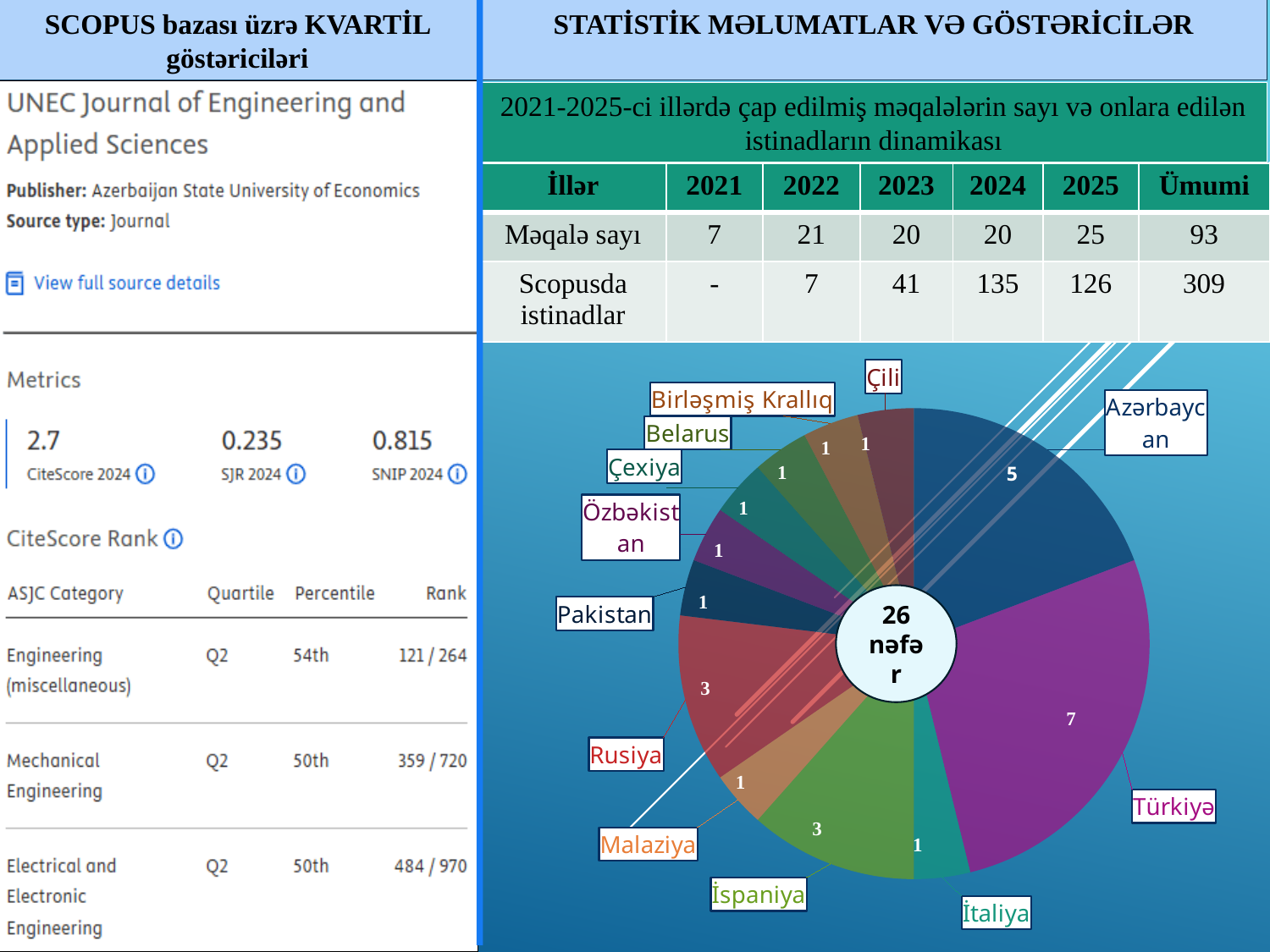
What value is shown for Rusiya in the pie chart? 3 What value is shown for Azərbaycan in the pie chart? 5 What value is shown for Pakistan in the pie chart? 1 What value is shown for İspaniya in the pie chart? 3 How many countries are shown in the pie chart? 12 What kind of chart is shown on the right side of the slide? pie chart What value is shown for Türkiyə in the pie chart? 7 What text is written in the centre of the pie chart? 26 nəfər Which is larger in the pie chart, the value for Azərbaycan or the value for İspaniya? Azərbaycan Which country has the largest slice in the pie chart? Türkiyə What is the difference between the values for Türkiyə and Azərbaycan in the pie chart? 2 What is the total of all the values in the pie chart? 26